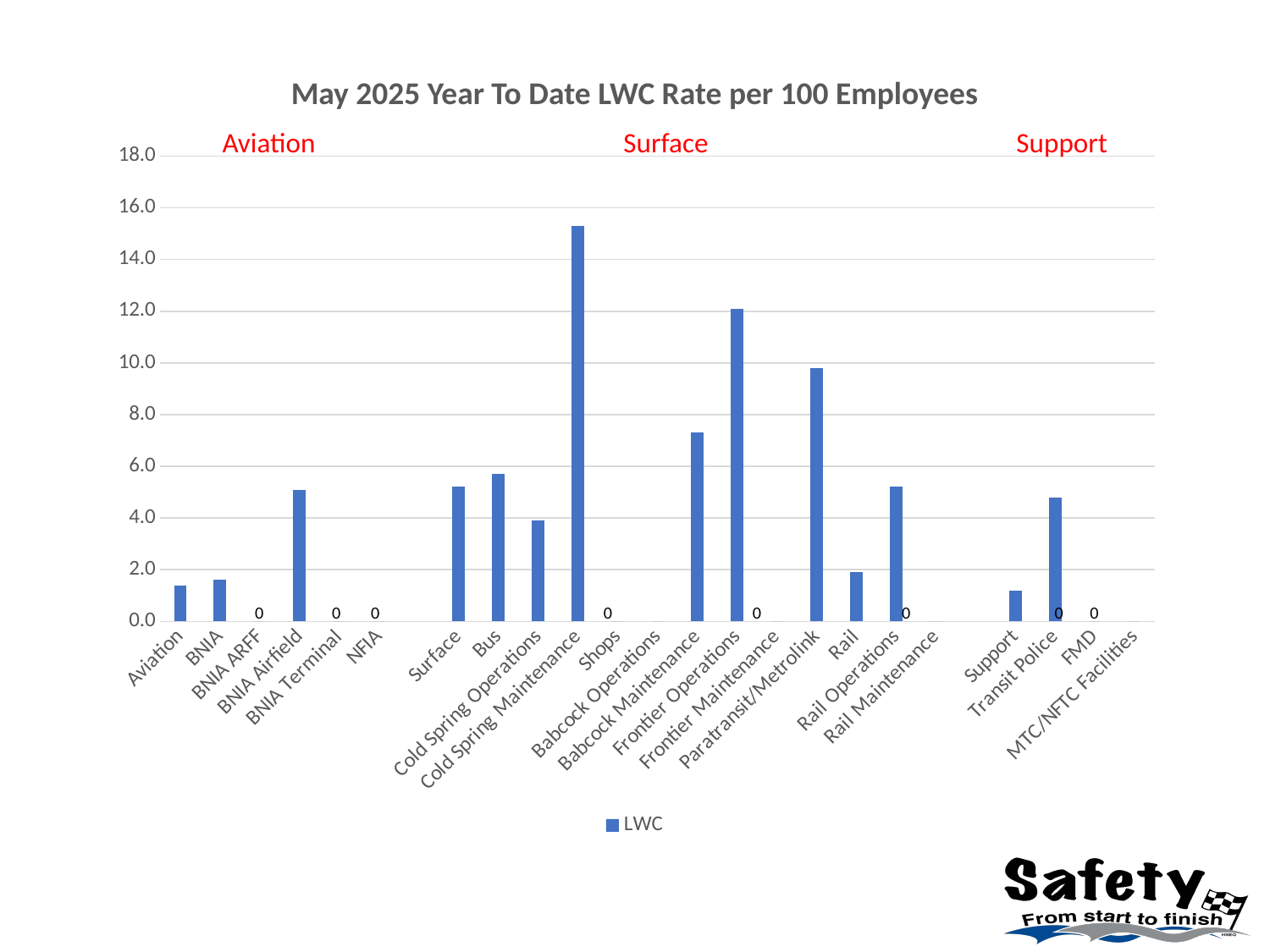
What are the three red group labels shown above the chart? Aviation, Surface, Support How many categories are shown along the x axis? 23 What is the title of the chart? May 2025 Year To Date LWC Rate per 100 Employees Is the value for Cold Spring Maintenance greater or less than 14.0? greater Which is larger, the value for Rail or the value for Rail Operations? Rail Operations Is the value for Aviation greater or less than 2.0? less Is the value for Frontier Operations greater or less than 10.0? greater How many series does the legend list? 1 What kind of chart is shown on the slide? Bar chart Which is larger, the value for Frontier Operations or the value for Paratransit/Metrolink? Frontier Operations Which category has the highest LWC rate? Cold Spring Maintenance